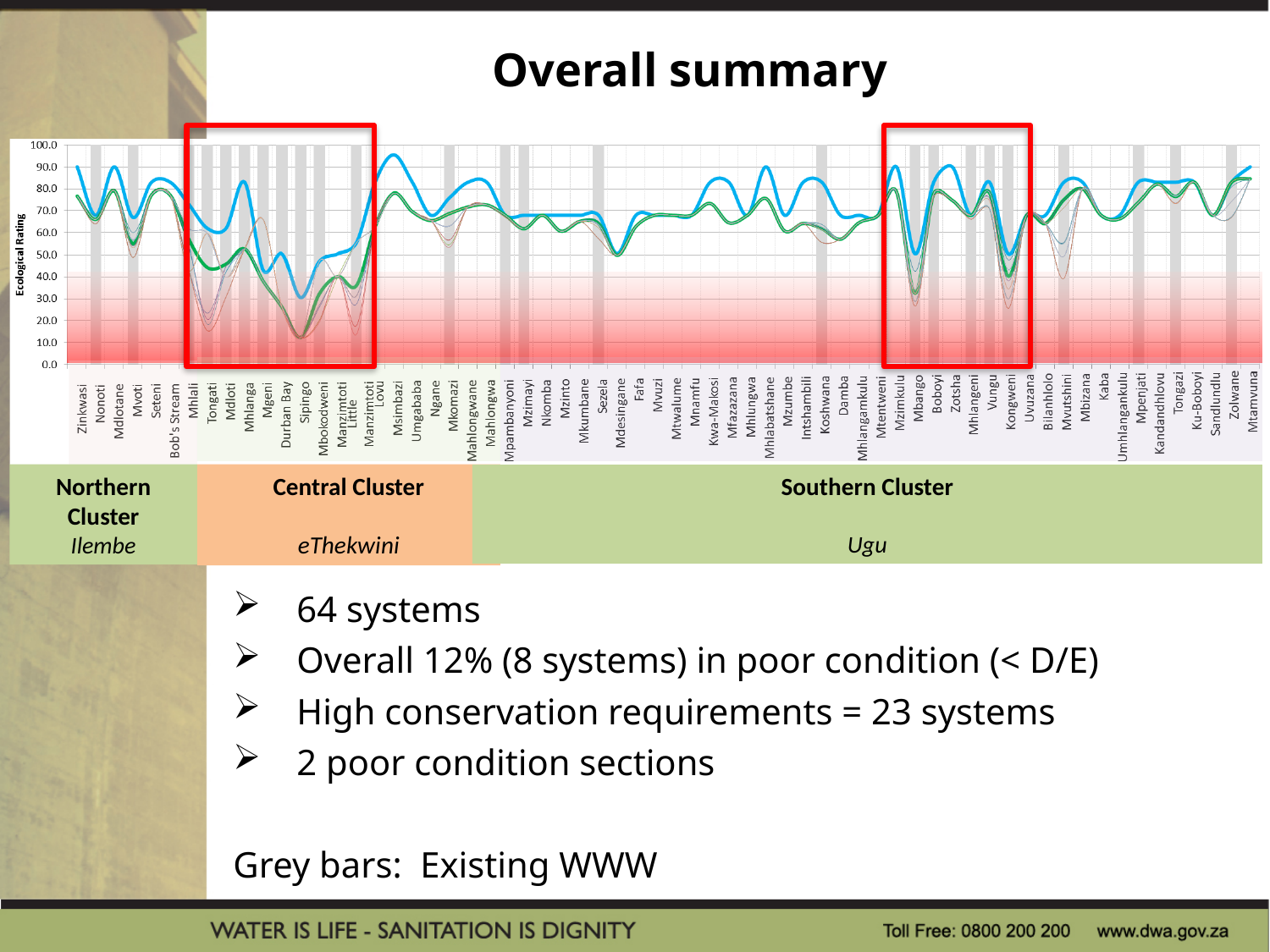
How many clusters are labelled beneath the chart? 3 Is the value for Mtamvuna greater or less than 70? greater Which has a higher ecological rating, Kongweni or Mzimkulu? Mzimkulu What is the maximum value shown on the y axis of the chart? 100.0 What kind of chart is shown on the slide? line chart How many systems (categories) are plotted along the x axis of the chart? 64 Which system has the lowest ecological rating on the chart? Sipingo What is the title of the chart's y axis? Ecological Rating Is the value for Lovu greater or less than 70? greater Is the value for Sipingo greater or less than 50? less Which has a higher ecological rating, Sipingo or Mtamvuna? Mtamvuna